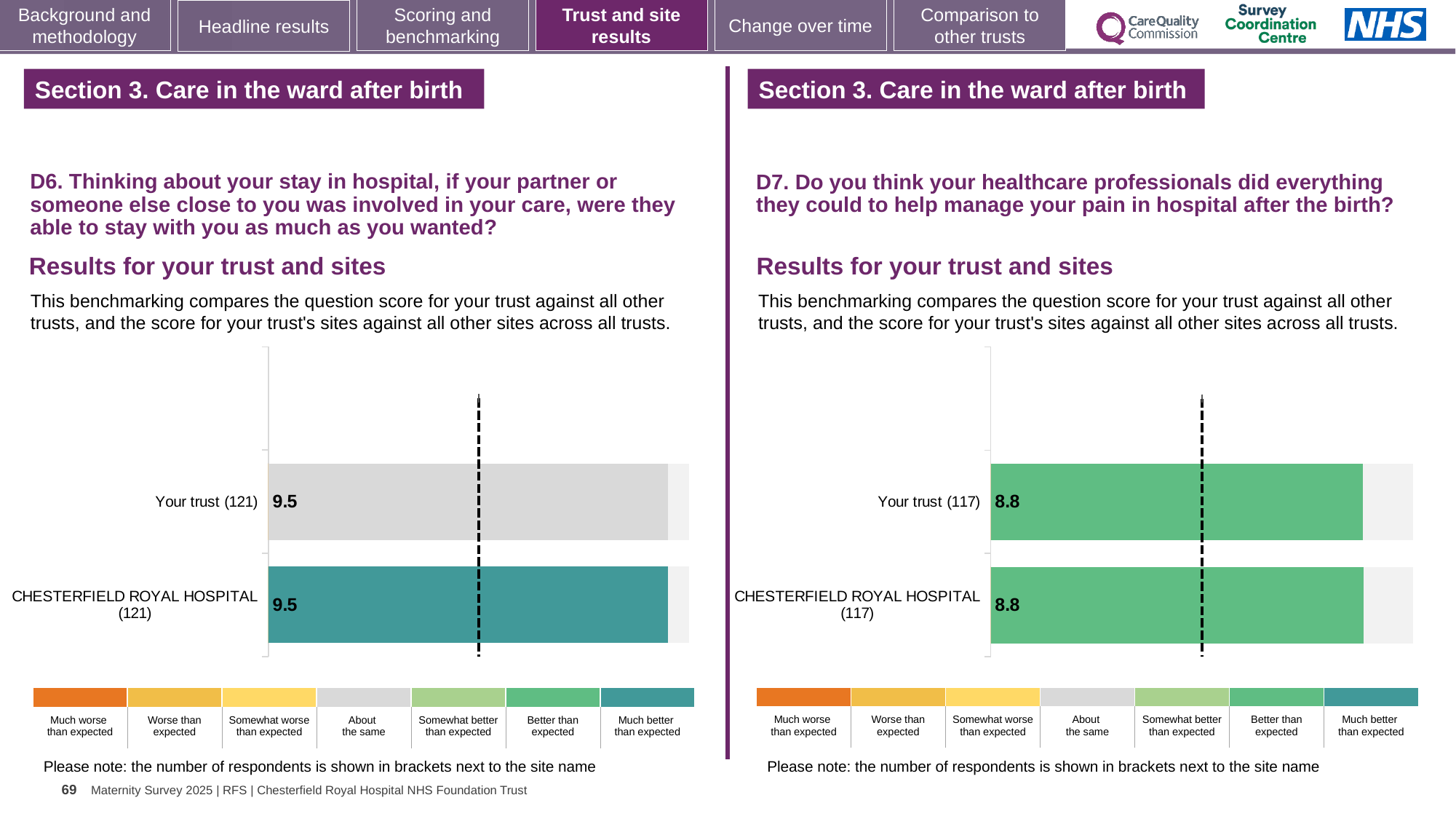
How many bars are plotted in the left chart (D6)? 2 How many bars are plotted in the right chart (D7)? 2 In the right chart (D7), what is the score for CHESTERFIELD ROYAL HOSPITAL (117)? 8.8 In the left chart (D6), which benchmark category does the colour of the CHESTERFIELD ROYAL HOSPITAL bar correspond to in the legend? Much better than expected In the left chart (D6), what is the score for CHESTERFIELD ROYAL HOSPITAL (121)? 9.5 How many respondents are shown in brackets for Your trust in the right chart (D7)? 117 In the right chart (D7), what is the difference between the score for Your trust and the score for CHESTERFIELD ROYAL HOSPITAL? 0 In the left chart (D6), what is the score for Your trust (121)? 9.5 In the left chart (D6), what is the difference between the score for Your trust and the score for CHESTERFIELD ROYAL HOSPITAL? 0 What kind of chart is used in the left chart (D6)? Bar chart In the right chart (D7), what is the score for Your trust (117)? 8.8 Is the score for Your trust in the left chart (D6) larger or smaller than the score for Your trust in the right chart (D7)? Larger